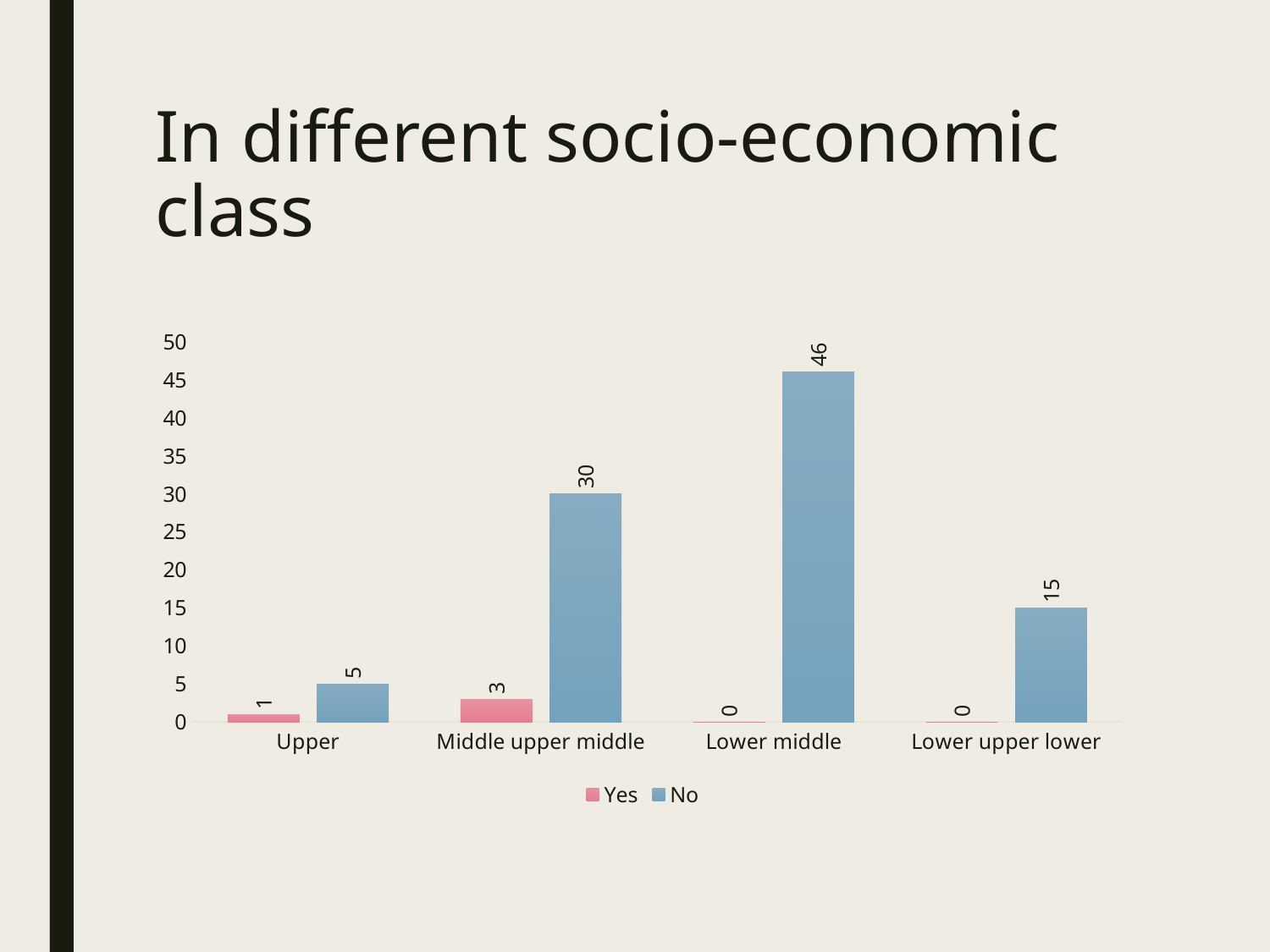
What is the value of the Yes series for Middle upper middle? 3 Which category has the lowest No value? Upper How many series does the legend list? 2 Which is larger, the No value for Upper or the No value for Lower upper lower? Lower upper lower Is the No value for Middle upper middle greater or less than 25? greater What is the difference between the No values for Lower middle and Middle upper middle? 16 Which category has the highest No value? Lower middle How many categories are shown on the x axis? 4 What is the value of the Yes series for Upper? 1 What is the value of the No series for Lower middle? 46 What is the value of the No series for Lower upper lower? 15 What kind of chart is shown on the slide? bar chart